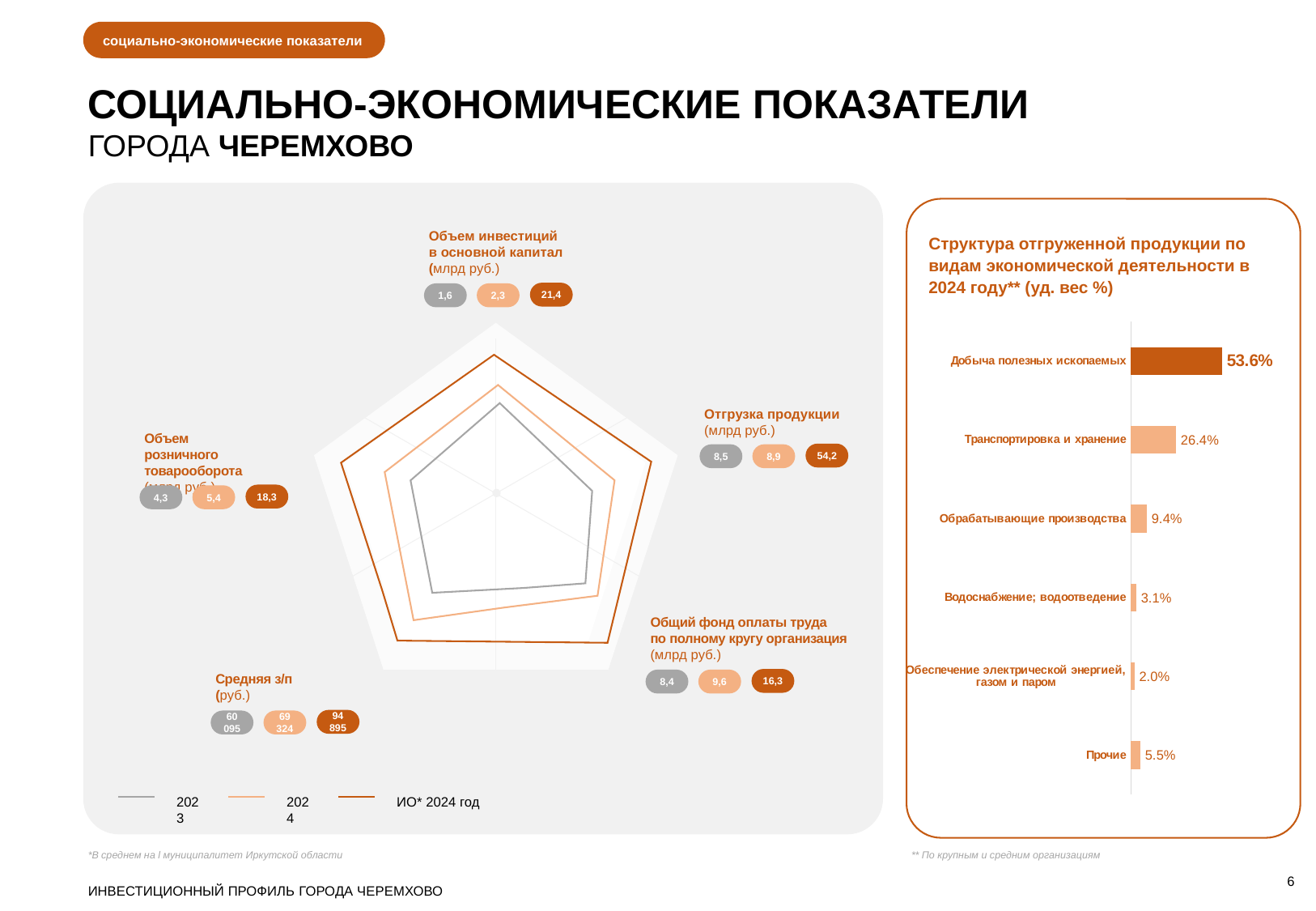
In the bar chart on the right, how many categories are shown? 6 In the bar chart on the right, what is the difference between the shares of Обрабатывающие производства and Прочие? 3.9% In the bar chart on the right, what is the share for Добыча полезных ископаемых? 53.6% In the bar chart on the right, which category has the lowest share? Обеспечение электрической энергией, газом и паром What type of chart is shown on the right side of the slide? Bar chart In the radar chart on the left, what is the 2024 value for Объем инвестиций в основной капитал (млрд руб.)? 2,3 In the radar chart on the left, how many series does the legend list? 3 In the radar chart on the left, which is larger for Общий фонд оплаты труда: the 2023 value or the 2024 value? 2024 In the radar chart on the left, what is the ИО* 2024 год value for Отгрузка продукции (млрд руб.)? 54,2 In the bar chart on the right, what is the share for Транспортировка и хранение? 26.4% In the bar chart on the right, which category has the highest share? Добыча полезных ископаемых In the radar chart on the left, what is the 2023 value for Средняя з/п (руб.)? 60 095